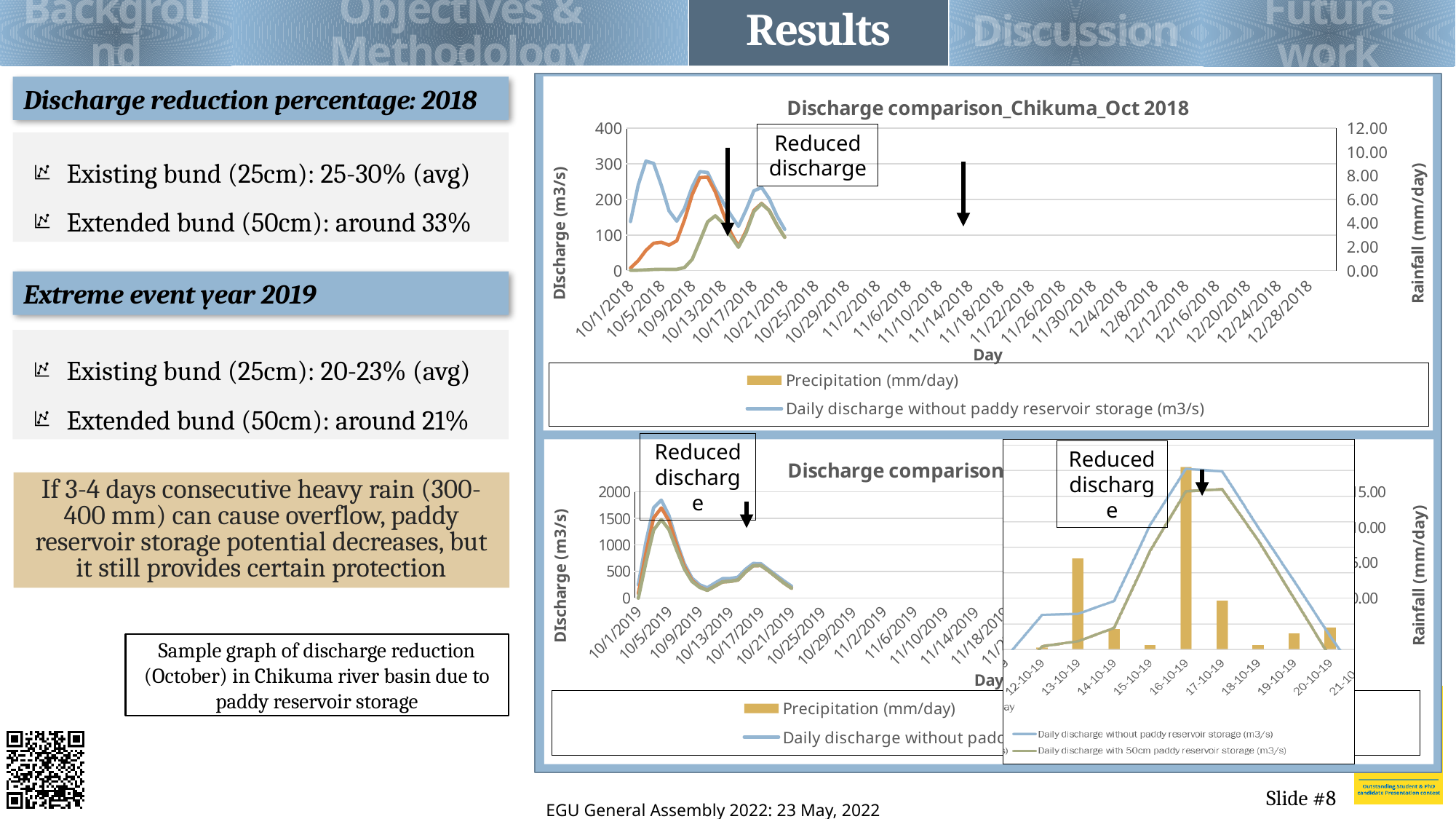
In the bottom chart (2019 discharge comparison), is the peak of the blue line near 10/5/2019 greater or less than 1500? greater In the top chart (Discharge comparison_Chikuma_Oct 2018), which line reaches a higher peak, the blue line or the green line? the blue line In the top chart (Discharge comparison_Chikuma_Oct 2018), what is the label of the right-hand vertical axis? Rainfall (mm/day) In the inset chart at the bottom right (dates 12-10-19 to 21-10-19), on which date is the precipitation bar tallest? 16-10-19 In the bottom chart (2019 discharge comparison), does the blue line rise or fall between 10/5/2019 and 10/13/2019? fall In the top chart (Discharge comparison_Chikuma_Oct 2018), does the blue line rise or fall between 10/1/2018 and 10/5/2018? rise What is the title of the top chart on the slide? Discharge comparison_Chikuma_Oct 2018 In the inset chart at the bottom right (dates 12-10-19 to 21-10-19), which precipitation bar is taller, 13-10-19 or 17-10-19? 13-10-19 In the top chart (Discharge comparison_Chikuma_Oct 2018), is the peak of the blue line near 10/5/2018 greater or less than 200? greater What kind of chart is the top chart (Discharge comparison_Chikuma_Oct 2018)? combination bar and line chart In the top chart (Discharge comparison_Chikuma_Oct 2018), is the highest point of the green line greater or less than 200? less In the inset chart at the bottom right (dates 12-10-19 to 21-10-19), how many series does the legend list? 2